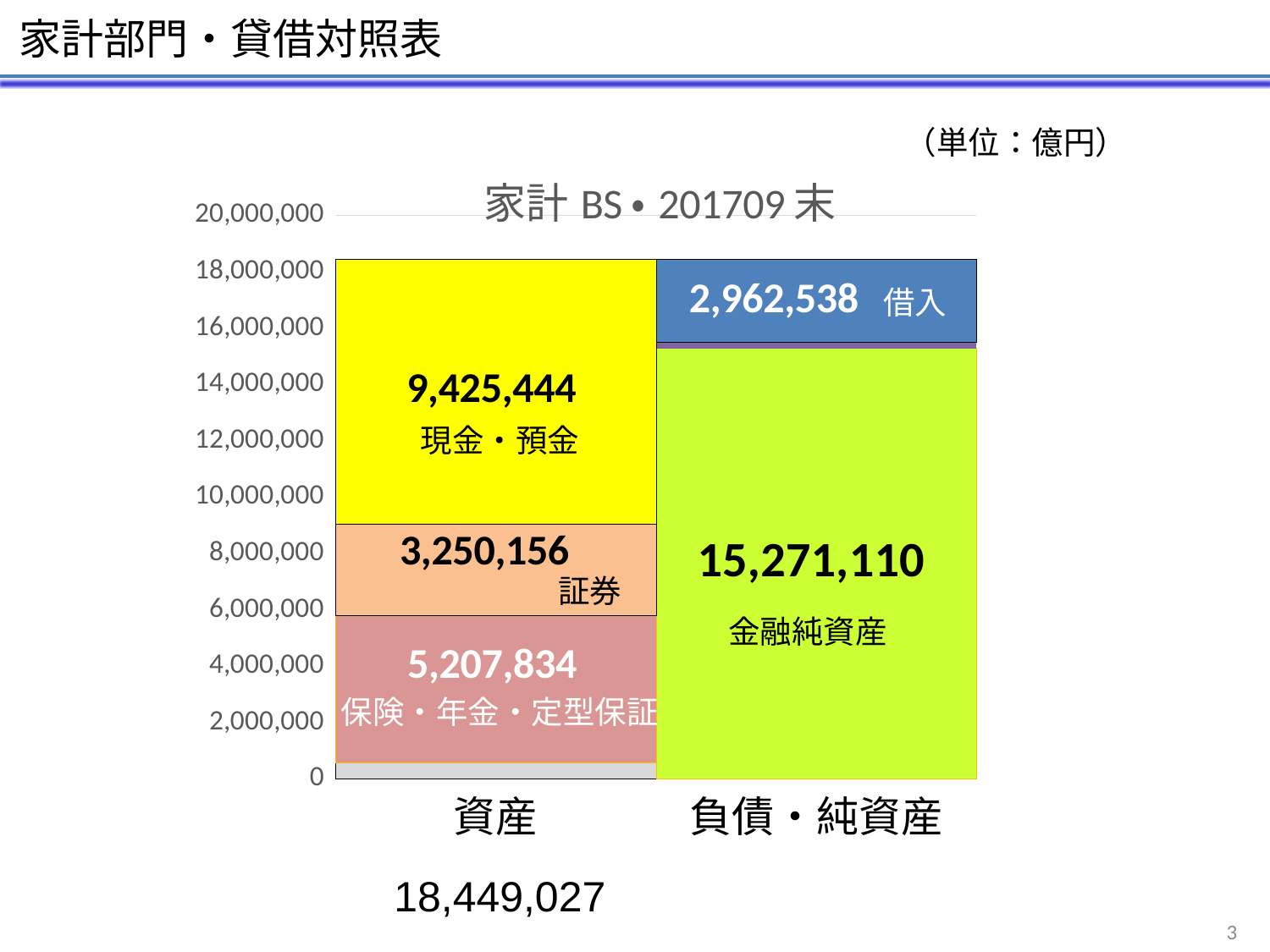
What is the value of the 金融純資産 segment? 15,271,110 What is the value of the 証券 segment in the 資産 bar? 3,250,156 What is the value of the 現金・預金 segment in the 資産 bar? 9,425,444 Which labelled segment of the 資産 bar has the largest value? 現金・預金 Which is larger, 金融純資産 or 借入? 金融純資産 How many bars (categories) are shown on the x axis? 2 What is the difference between the 現金・預金 value and the 証券 value? 6,175,288 What is the value of the 保険・年金・定型保証 segment? 5,207,834 What is the total of the 資産 bar as printed on the slide? 18,449,027 What is the title of the chart? 家計 BS・201709 末 Which labelled segment of the 資産 bar has the smallest value? 証券 What is the value of the 借入 segment in the 負債・純資産 bar? 2,962,538